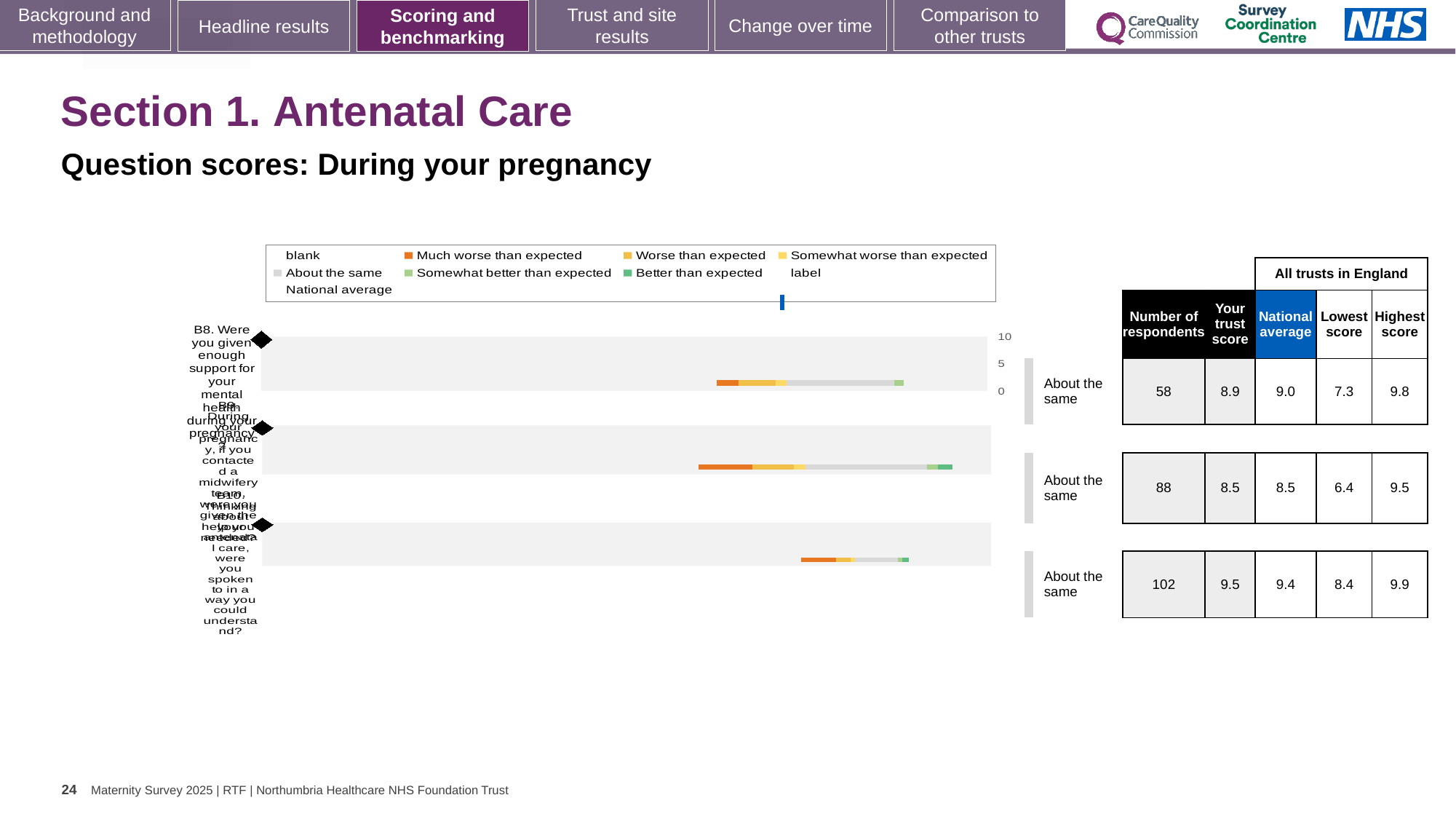
Which of the three rows has the lowest trust score? the second row (B9), 8.5 Is the trust score for the third row (B10) larger or smaller than its national average? larger How many question rows (bars) does the chart show? 3 What kind of chart is shown on the slide? bar chart In the table next to the chart, what is the highest score for the third row (B10)? 9.9 In the table next to the chart, what is the lowest score for the second row (B9)? 6.4 What is the difference between the highest score and the lowest score for the first row (B8)? 2.5 What benchmark category label is shown to the right of each bar in the chart? About the same In the table next to the chart, what is the trust score for the first row (B8)? 8.9 In the table next to the chart, what is the number of respondents for the first row (B8, support for your mental health during pregnancy)? 58 In the table next to the chart, what is the national average for the second row (B9)? 8.5 Which of the three rows has the highest number of respondents? the third row (B10), 102